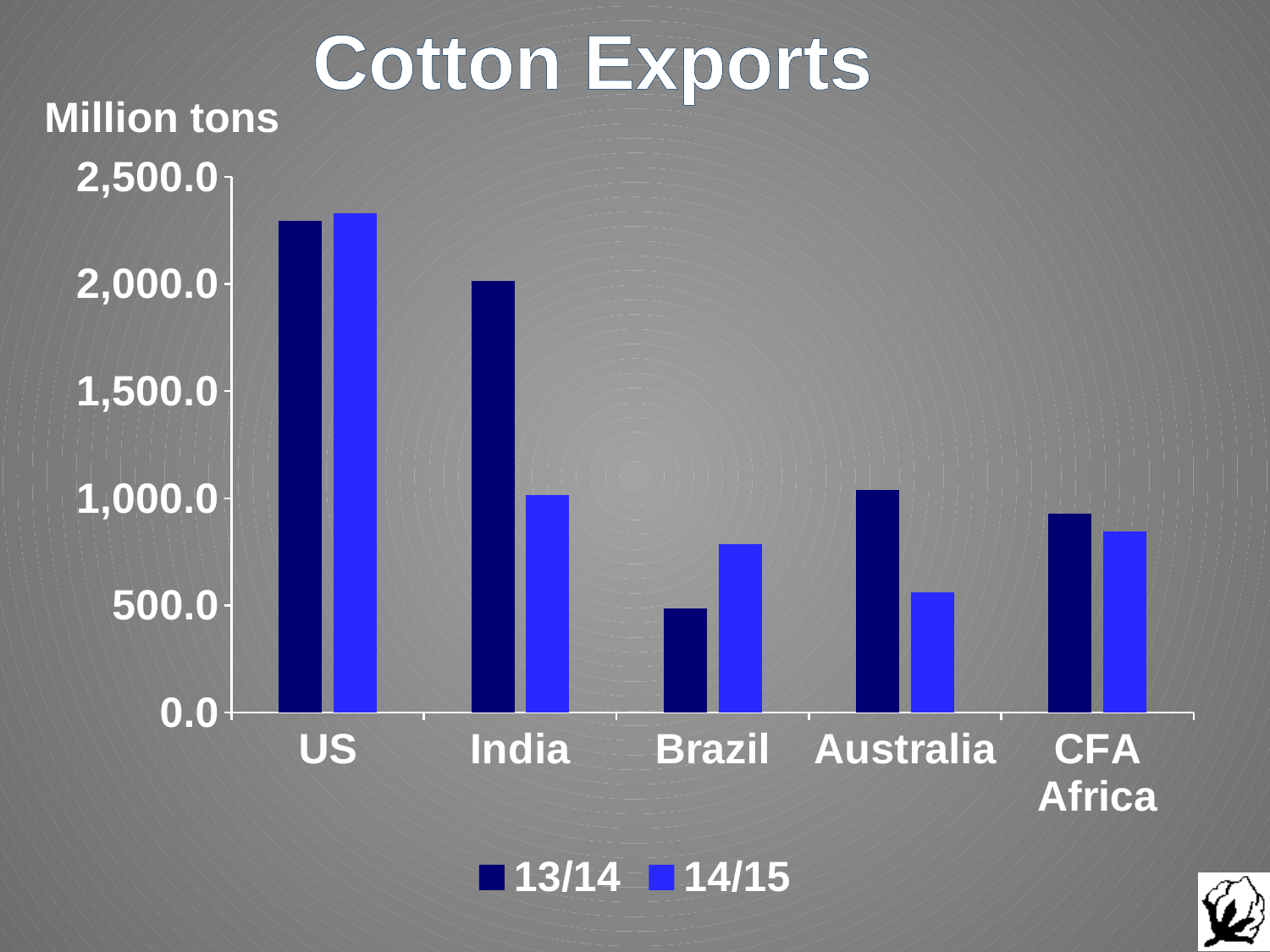
For Brazil, which series has the larger value, 13/14 or 14/15? 14/15 Is the 13/14 value for US greater or less than 2,000.0? greater Which country has the lowest cotton exports in the 13/14 series? Brazil Which country has the highest cotton exports in the 13/14 series? US Which country has the lowest cotton exports in the 14/15 series? Australia For India, which series has the larger value, 13/14 or 14/15? 13/14 How many series does the legend list? 2 Is the 13/14 value for Brazil greater or less than 1,000.0? less How many countries or regions are shown on the x axis? 5 Is the 13/14 value for Australia greater or less than 1,500.0? less What kind of chart is shown on the slide? bar chart What unit is given for the y axis of the chart? Million tons